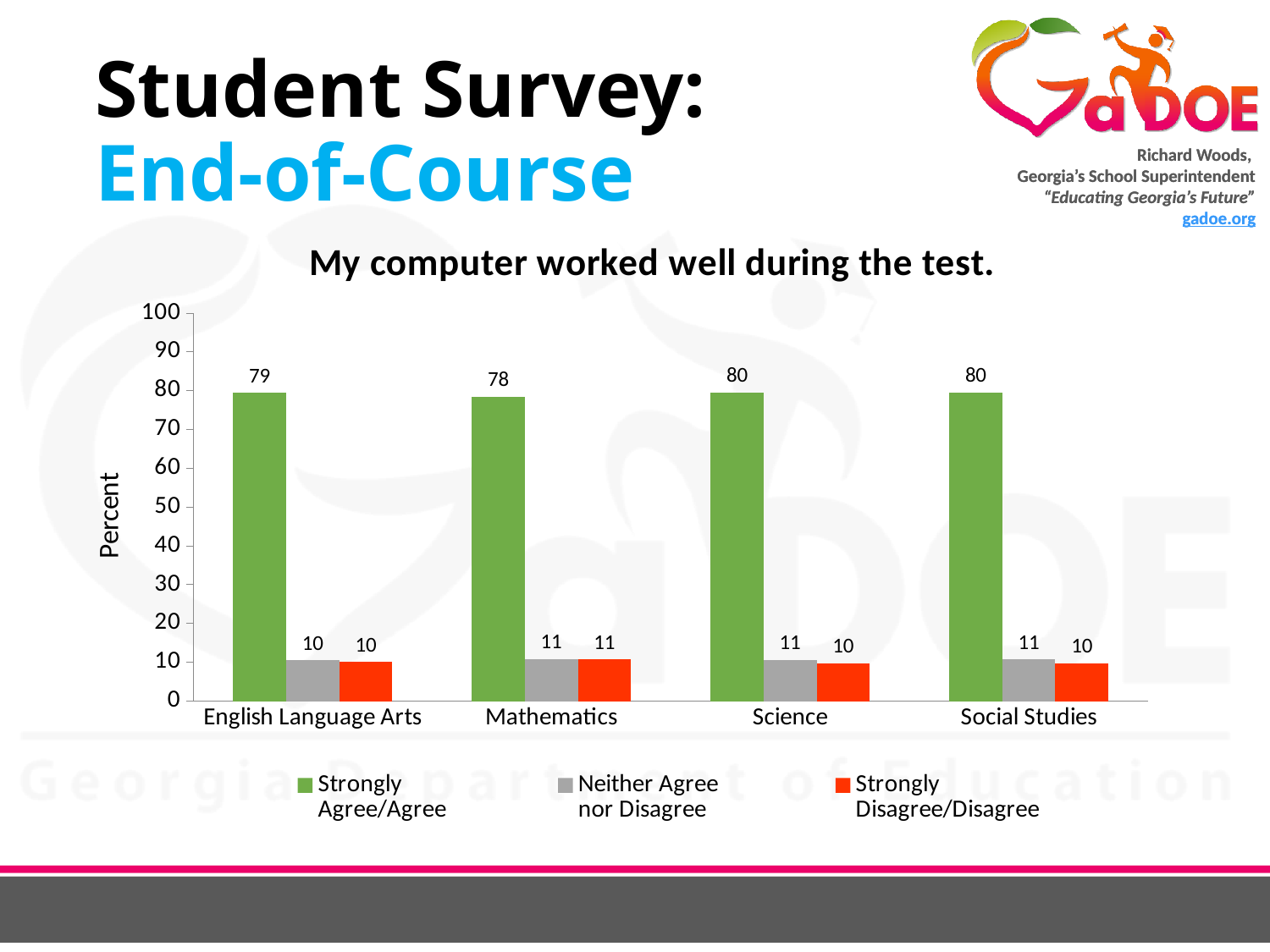
What is the label on the y axis? Percent What is the title of the chart? My computer worked well during the test. Is the Strongly Agree/Agree value for Social Studies greater or less than 70? greater How many subjects are shown on the x axis? 4 What is the Strongly Agree/Agree value for English Language Arts? 79 How many series does the legend list? 3 What is the difference between the Strongly Agree/Agree values for Science and Mathematics? 2 What kind of chart is shown? bar chart What is the Neither Agree nor Disagree value for Science? 11 What is the Strongly Disagree/Disagree value for Mathematics? 11 Which is larger for Social Studies: Neither Agree nor Disagree or Strongly Disagree/Disagree? Neither Agree nor Disagree Which subject has the lowest Strongly Agree/Agree value? Mathematics